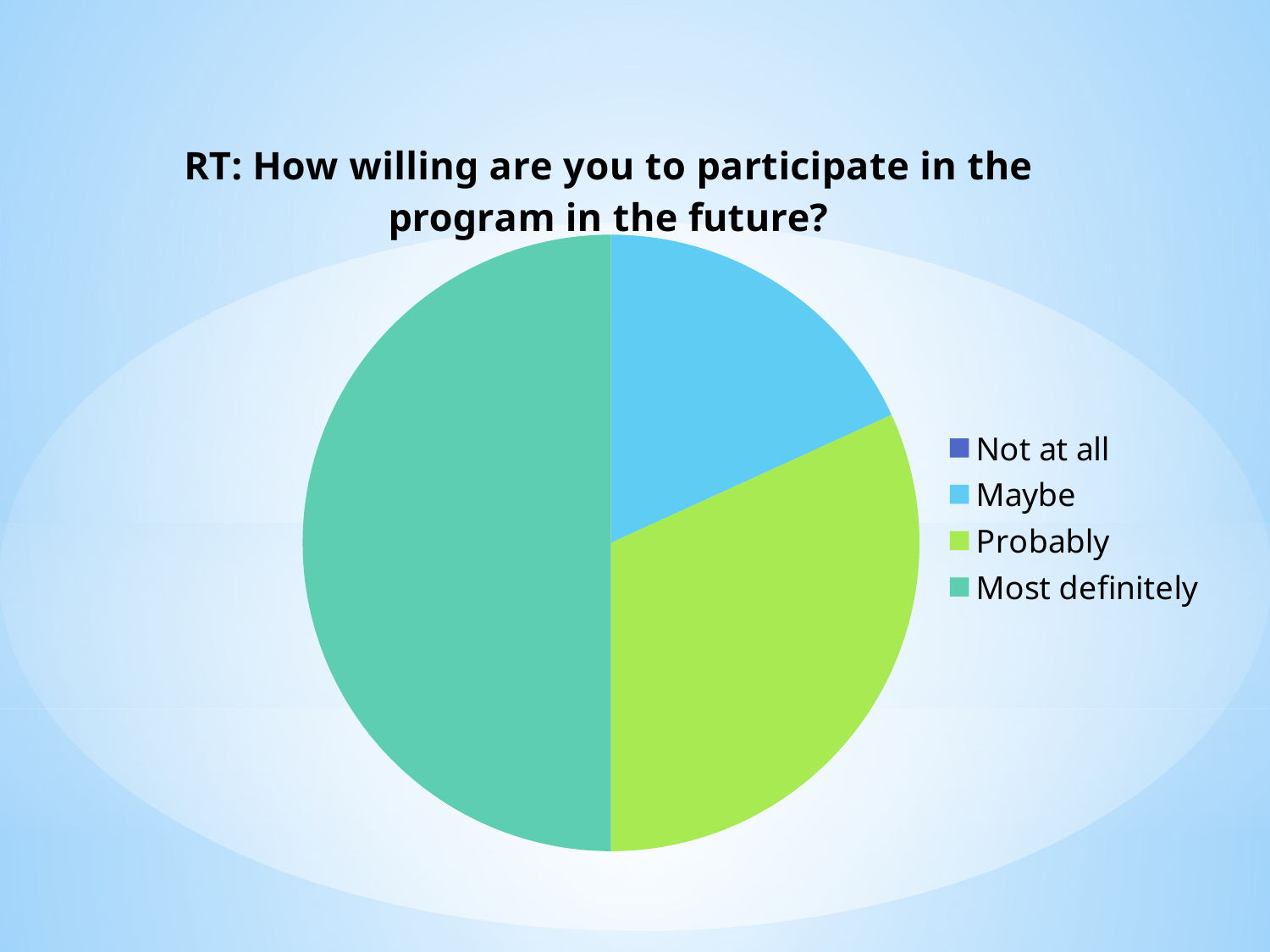
Which category has the largest slice of the pie? Most definitely What kind of chart is shown on the slide? Pie chart What is the title of the chart? RT: How willing are you to participate in the program in the future? How many entries does the chart's legend list? 4 How many slices are visible in the pie? 3 Which legend category has no visible slice in the pie? Not at all Which slice is larger, Probably or Maybe? Probably Which slice is larger, Most definitely or Probably? Most definitely Which of the visible slices is the smallest? Maybe